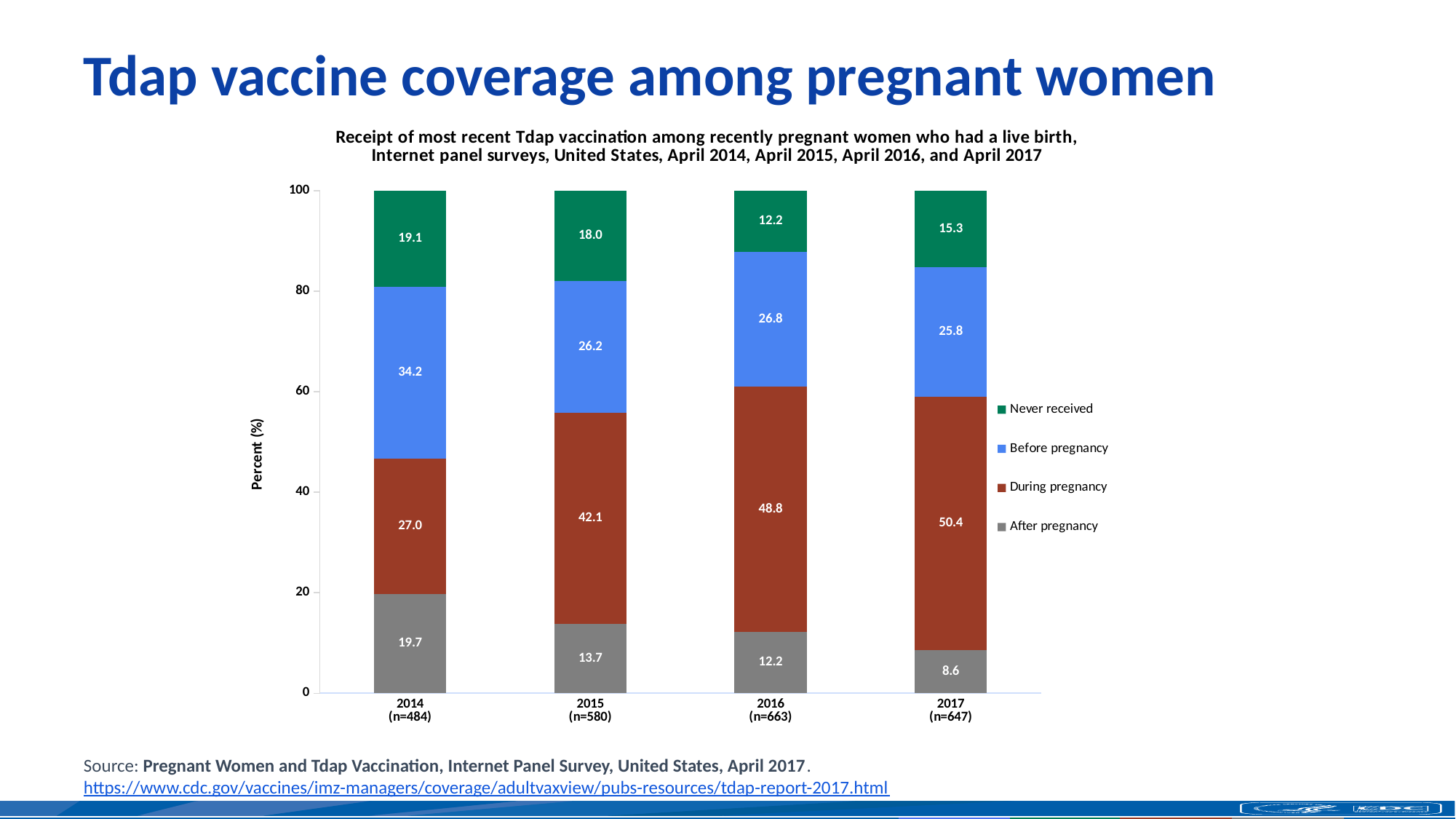
What is the difference between the During pregnancy values for 2017 and 2014? 23.4 What is the value for Never received in 2016? 12.2 How many series does the legend list? 4 In which year is the During pregnancy value highest? 2017 What is the value for After pregnancy in 2014? 19.7 What kind of chart is shown on the slide? stacked bar chart Does the After pregnancy value rise or fall from 2014 to 2017? fall What is the value for During pregnancy in 2017? 50.4 How many years are shown on the x axis? 4 In which year is the After pregnancy value lowest? 2017 Does the During pregnancy value rise or fall from 2014 to 2017? rise Which year has the larger Before pregnancy value, 2014 or 2016? 2014